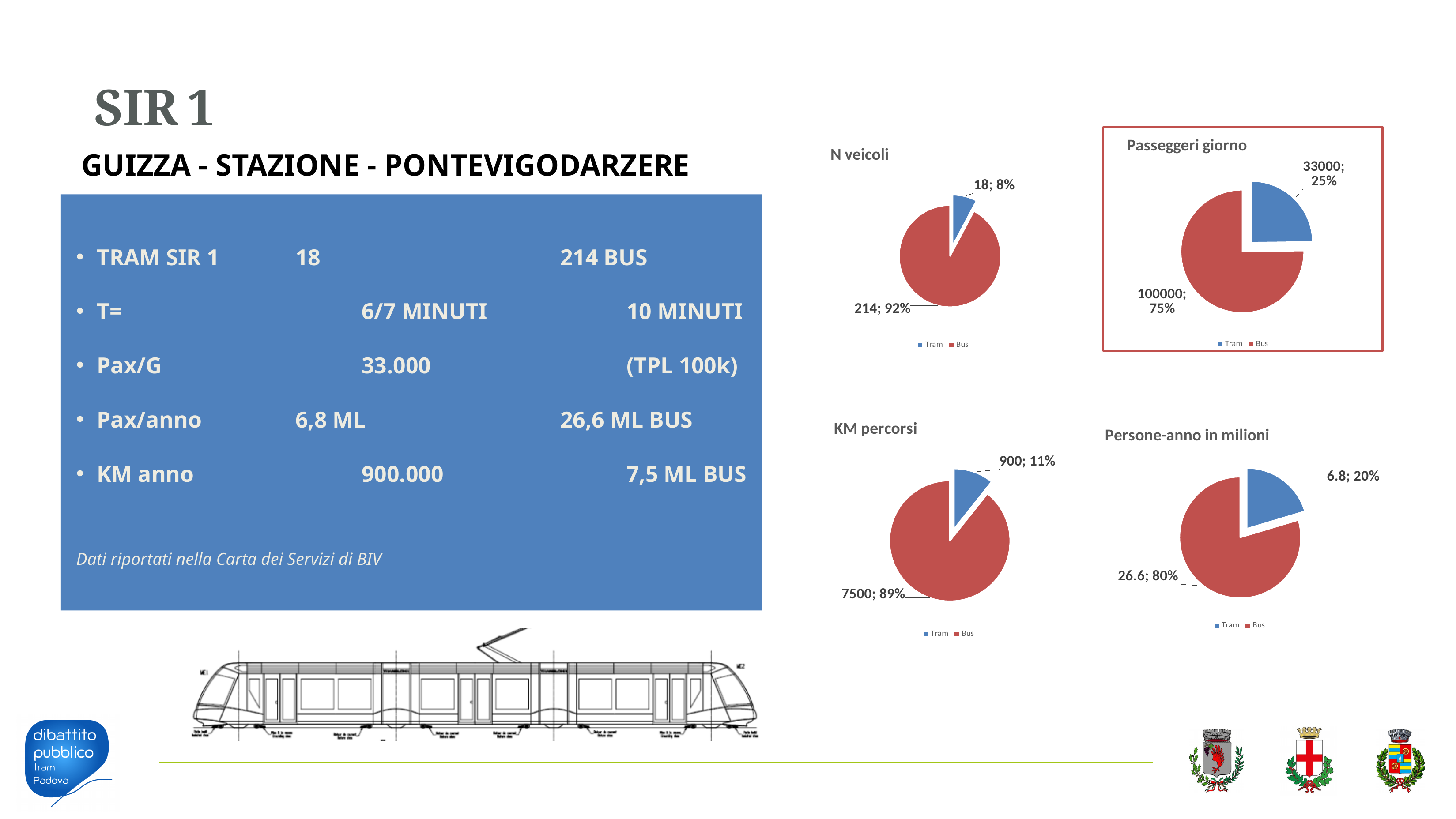
In the 'KM percorsi' chart, what is the value for Tram? 900 What kind of chart is 'KM percorsi'? Pie chart In the 'Passeggeri giorno' chart, what is the value for Bus? 100000 In the 'Persone-anno in milioni' chart, which category is the largest? Bus In the 'N veicoli' chart, what share of the pie does Bus have? 92% How many series does the legend of the 'N veicoli' chart list? 2 In the 'Passeggeri giorno' chart, what share of the pie does Tram have? 25% In the 'Persone-anno in milioni' chart, what is the value for Bus? 26.6 In the 'Passeggeri giorno' chart, which is larger, Tram or Bus? Bus In the 'KM percorsi' chart, what is the difference between the Bus and Tram values? 6600 In the 'N veicoli' chart, what is the value for Tram? 18 In the 'Persone-anno in milioni' chart, what colour is the Tram slice? Blue